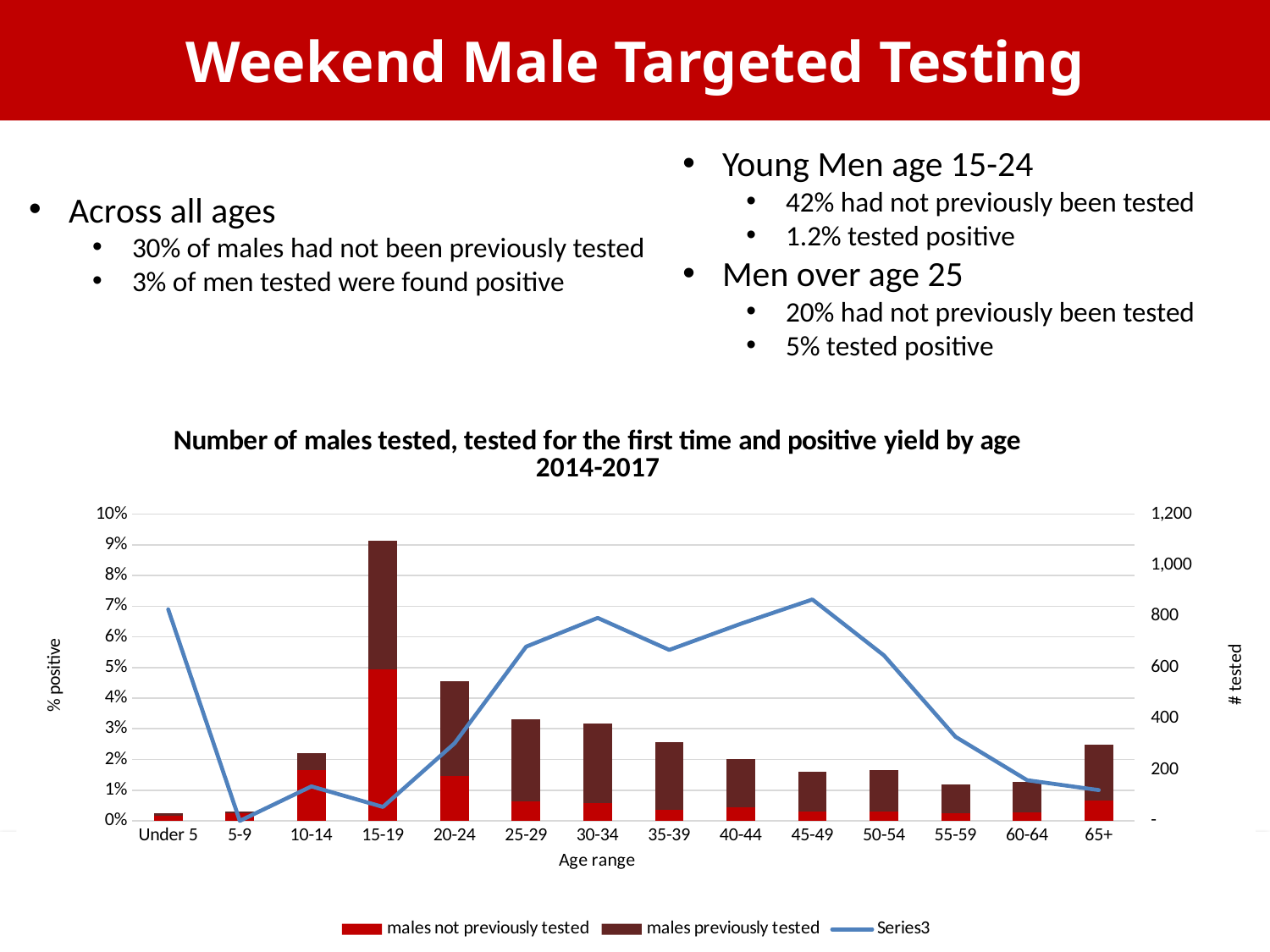
Is the Series3 line value for Under 5 greater or less than 600? greater What kind of chart is shown on the slide? Stacked bar chart with a line What is the label of the right-hand vertical axis? # tested Is the Series3 line value for 55-59 greater or less than 400? less Which age range has the tallest stacked bar (highest % positive)? 15-19 Does the Series3 line rise or fall from 45-49 to 65+? fall How many series does the chart legend list? 3 Is the total stacked bar value for 15-19 greater or less than 8%? greater Which has the taller stacked bar, 20-24 or 25-29? 20-24 How many age-range categories are shown on the x axis of the chart? 14 Which age range has the lowest value on the Series3 line (# tested)? 5-9 Which age range has the highest value on the Series3 line (# tested)? 45-49